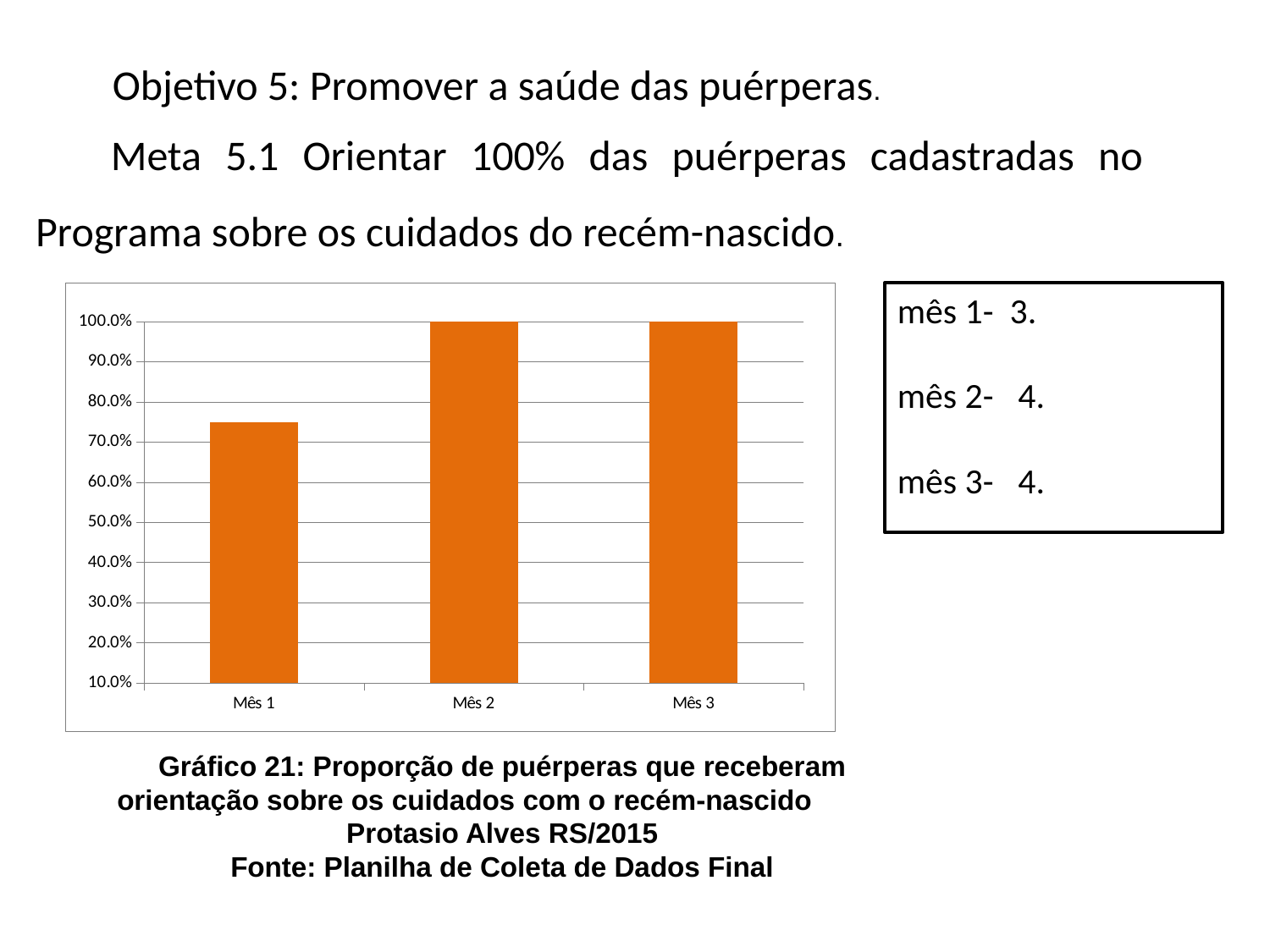
Do the values rise or fall from Mês 1 to Mês 2? rise What colour are the bars in the chart? orange What kind of chart is shown on the slide? bar chart Which month has the lowest value? Mês 1 Which is larger, the value for Mês 1 or the value for Mês 2? Mês 2 Is the value for Mês 1 greater or less than 80.0%? less Is the value for Mês 1 greater or less than 70.0%? greater What is the number of the graph according to the caption below the chart? Gráfico 21 What is the value for Mês 3? 100.0% What is the difference between the values for Mês 2 and Mês 3? 0.0% What is the value for Mês 2? 100.0% How many months are shown on the x axis? 3